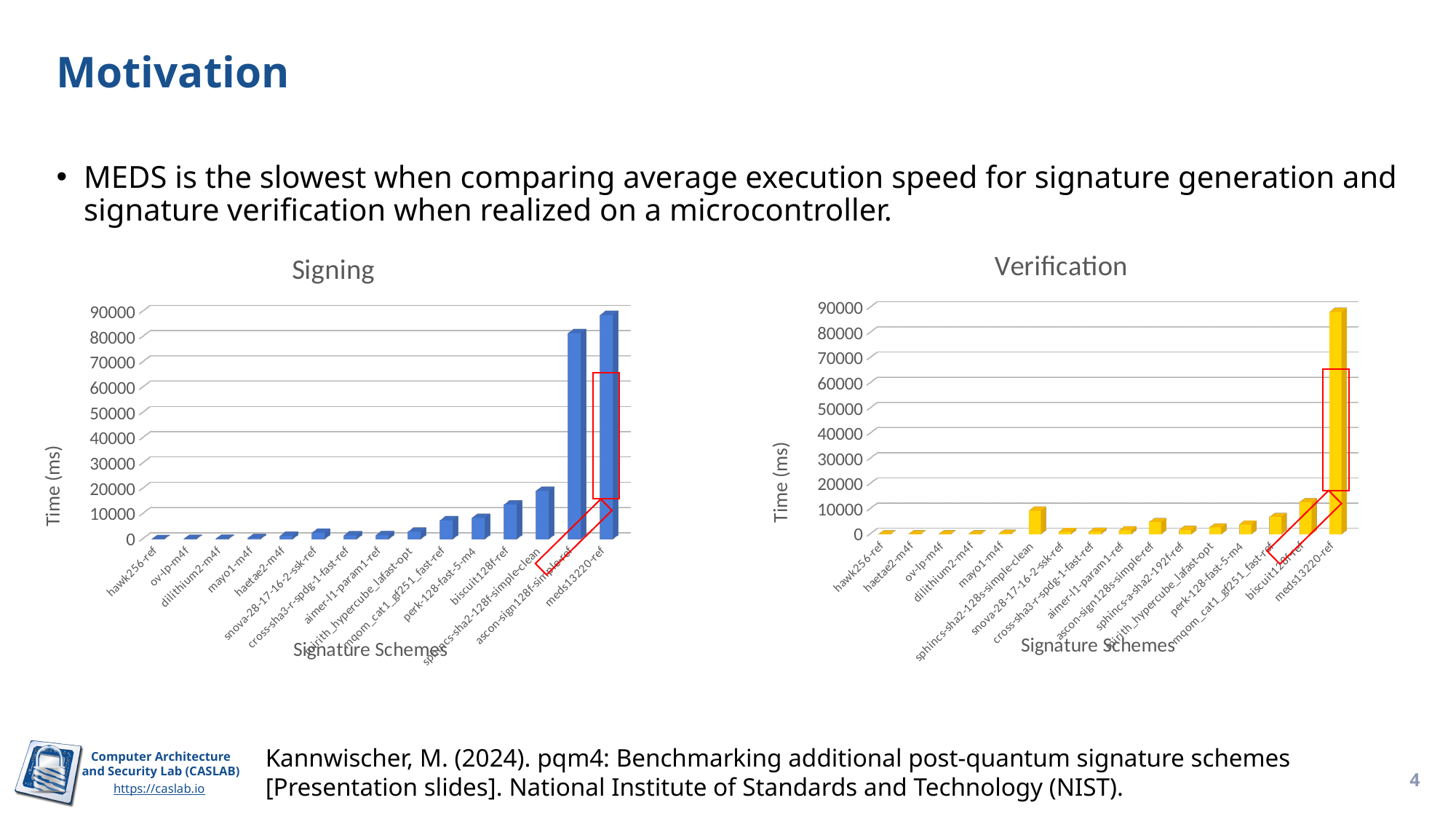
In the Signing chart, is the value for ascon-sign128f-simple-ref greater or less than 70000? greater In the Verification chart, is the value for meds13220-ref greater or less than 80000? greater In the Signing chart, which signature scheme has the highest time? meds13220-ref How many signature schemes are shown in the Verification chart? 16 In the Signing chart, is the value for sphincs-sha2-128f-simple-clean greater or less than 10000? greater In the Verification chart, do the values generally rise or fall from left to right along the x axis? rise How many signature schemes are shown in the Signing chart? 15 In the Signing chart, which has the larger value, meds13220-ref or ascon-sign128f-simple-ref? meds13220-ref What kind of chart is the Signing chart? bar chart In the Verification chart, which signature scheme has the highest time? meds13220-ref